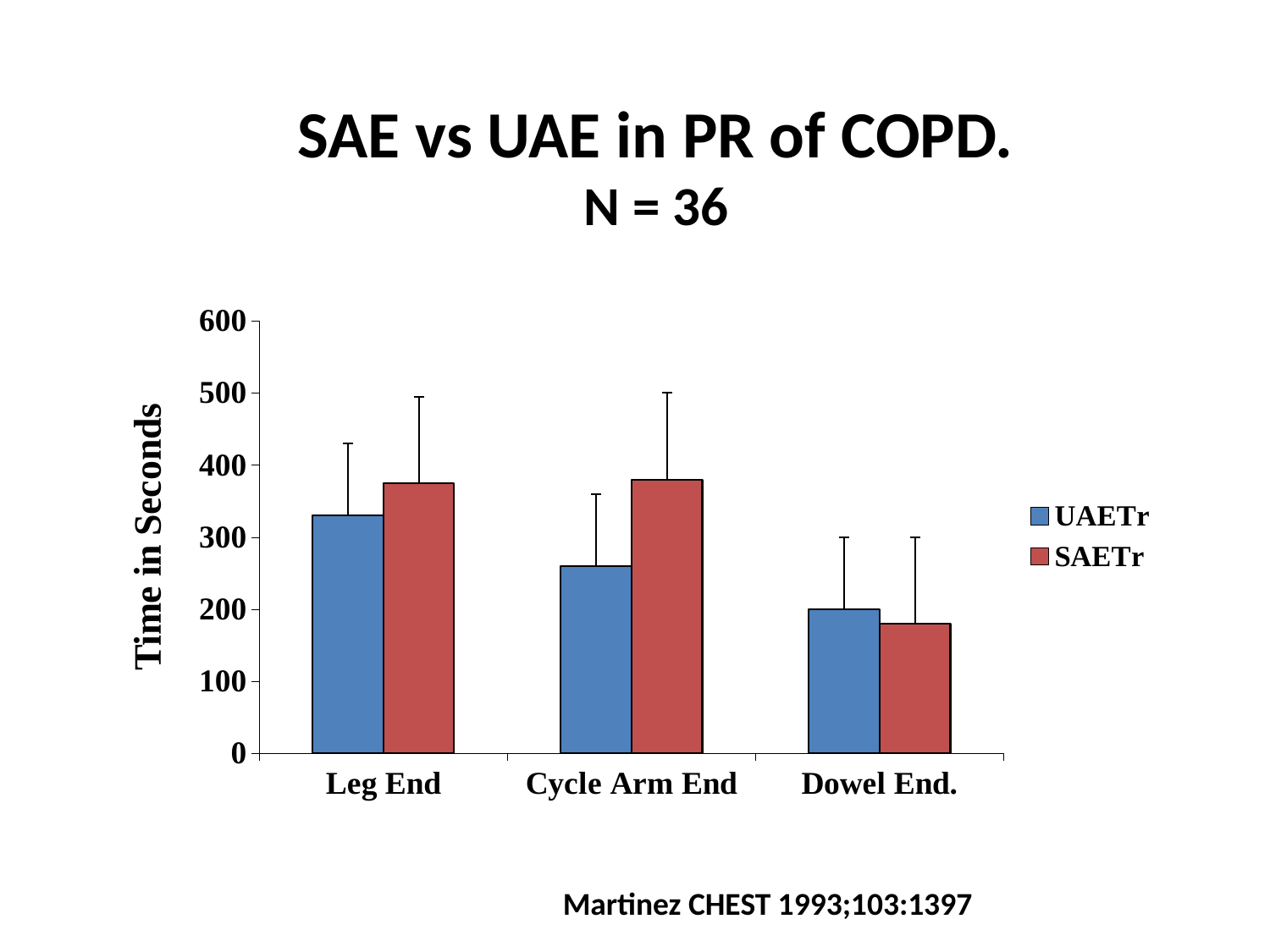
Is the SAETr value for Dowel End. greater or less than 200? less Do the UAETr values rise or fall from Leg End to Dowel End. along the x axis? fall How many categories are shown on the x axis? 3 Is the UAETr value for Leg End greater or less than 300? greater Is the SAETr value for Cycle Arm End greater or less than 300? greater Which category has the highest UAETr value? Leg End For Leg End, which series has the larger value, UAETr or SAETr? SAETr Which category has the lowest SAETr value? Dowel End. For Cycle Arm End, which series has the larger value, UAETr or SAETr? SAETr What kind of chart is shown on the slide? bar chart How many series does the legend list? 2